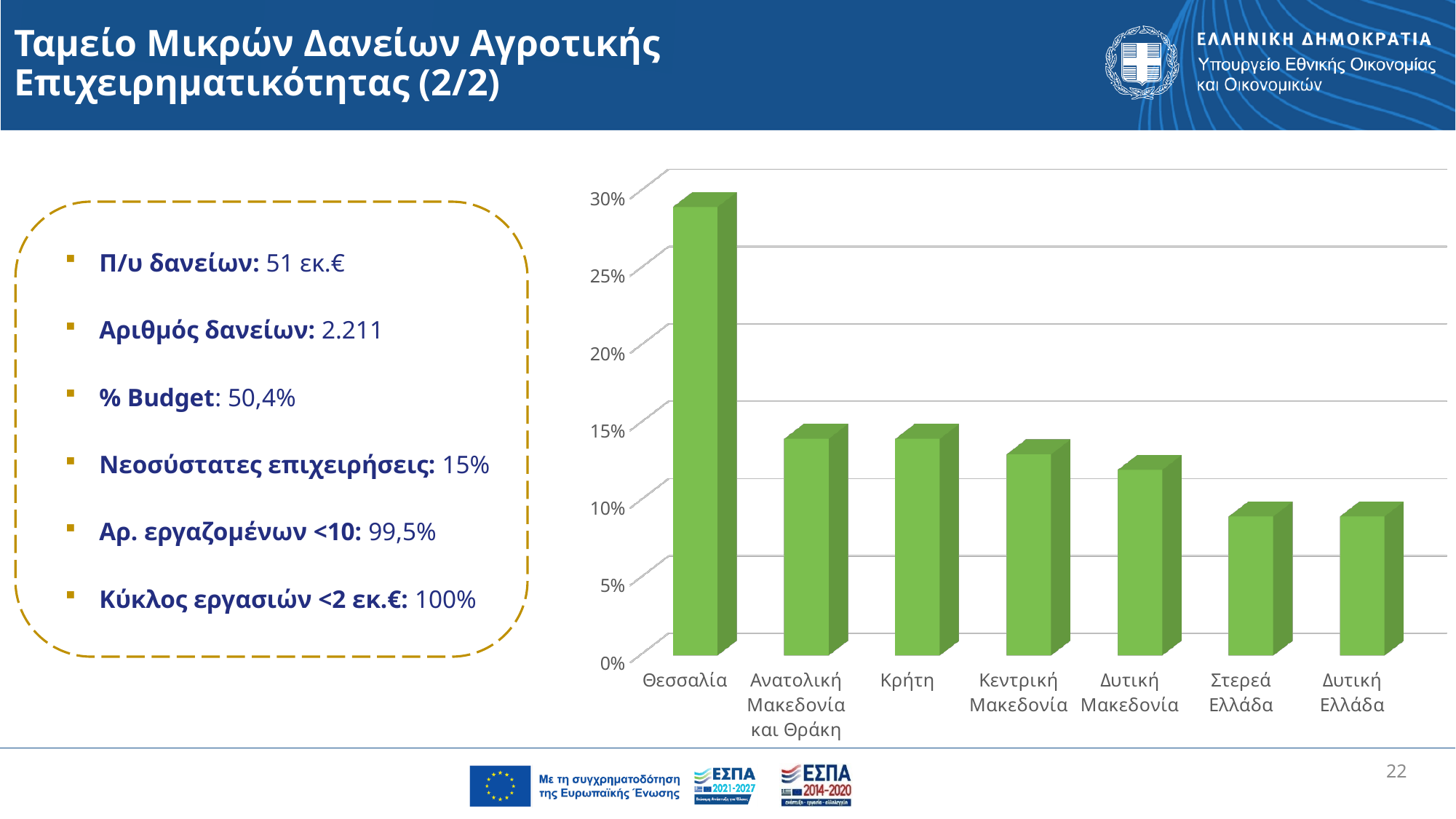
Which is larger, the value for Θεσσαλία or the value for Κρήτη? Θεσσαλία How many regions are shown on the x axis of the chart? 7 Do the bar values generally rise or fall from left to right along the x axis? fall Is the value for Δυτική Ελλάδα greater or less than 5%? greater What colour are the bars in the chart? green Is the value for Θεσσαλία greater or less than 25%? greater Which region has the highest bar in the chart? Θεσσαλία What kind of chart is shown on the slide? bar chart Is the value for Κεντρική Μακεδονία greater or less than 10%? greater Which is larger, the value for Δυτική Μακεδονία or the value for Δυτική Ελλάδα? Δυτική Μακεδονία